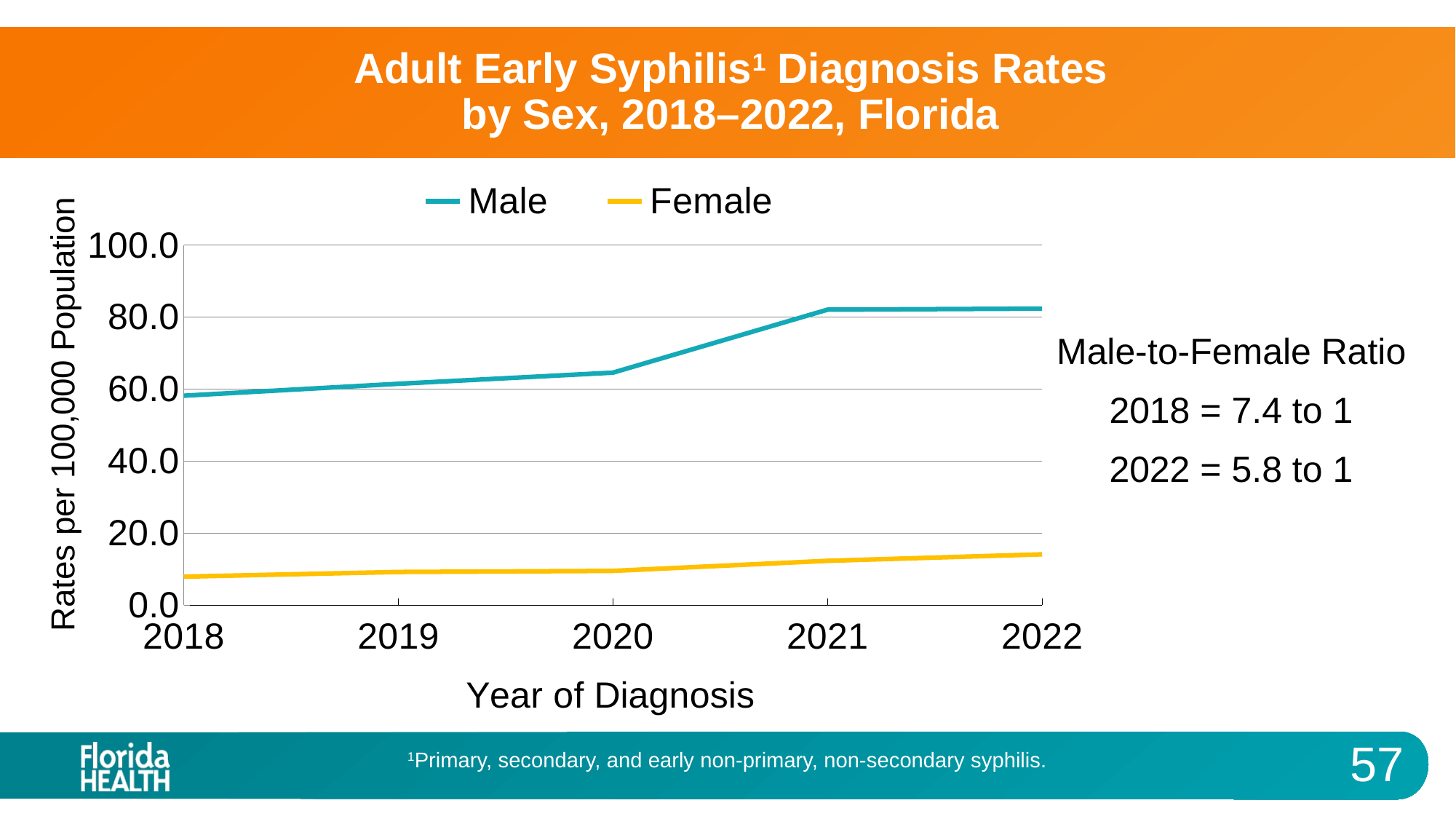
Is the Male rate in 2022 greater or less than 60.0? greater Which series has the higher rate in 2021, Male or Female? Male Does the Female rate rise or fall from 2018 to 2022? rise How many years are plotted along the x axis? 5 Is the Male rate in 2020 greater or less than 60.0? greater How many series does the legend list? 2 In which year is the Male rate lowest? 2018 What kind of chart is shown on the slide? line chart According to the text on the slide, what was the Male-to-Female ratio in 2018? 7.4 to 1 Is the Female rate in 2018 greater or less than 20.0? less In which year is the Female rate highest? 2022